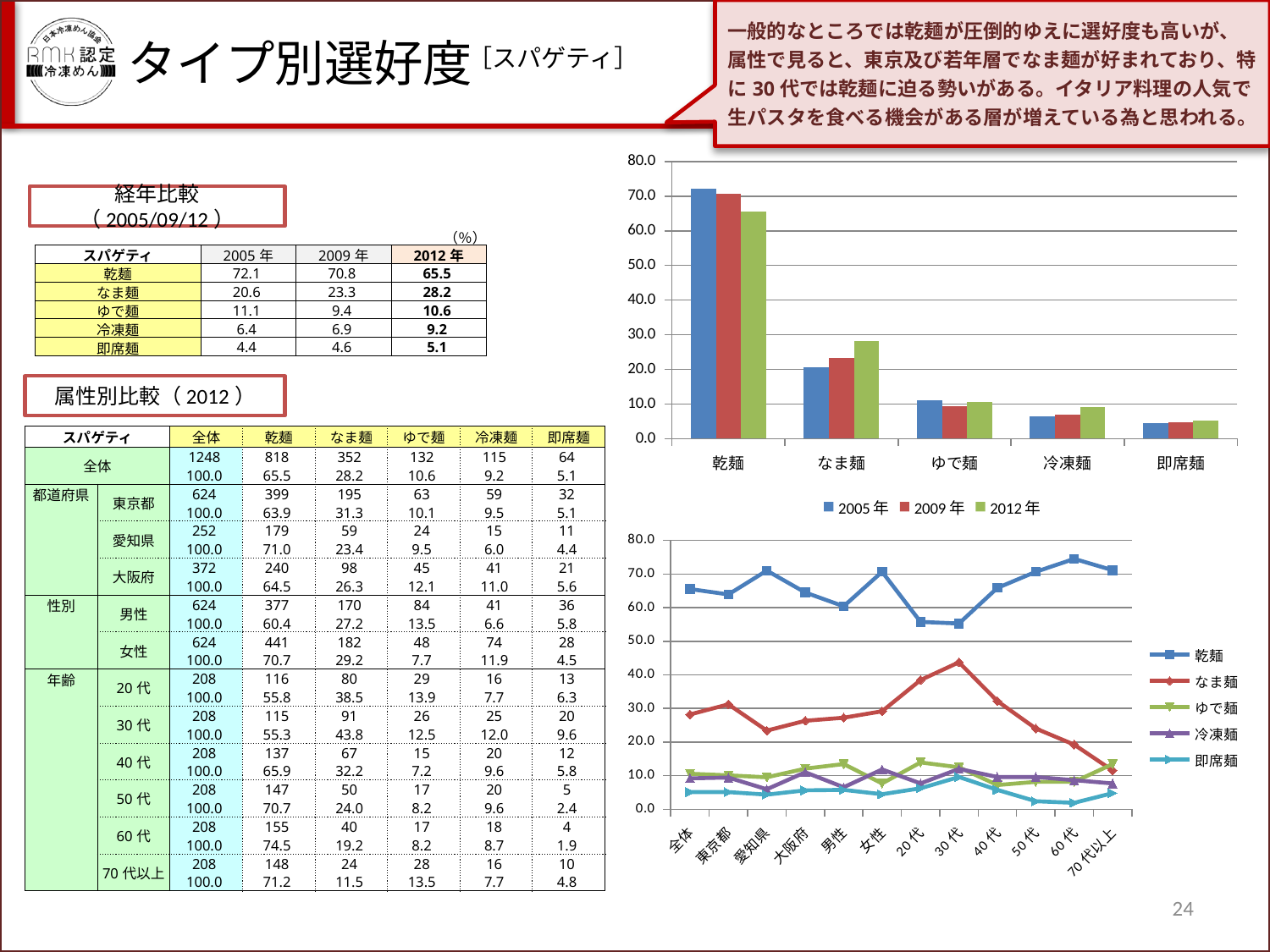
In the bottom line chart, how many series does the legend list? 5 In the top bar chart, do the values for なま麺 rise or fall from 2005年 to 2012年? rise What kind of chart is the top chart on the right of the slide? bar chart In the top bar chart, is the 2005年 value for 乾麺 greater or less than 70.0? greater In the top bar chart, how many categories are shown on the x axis? 5 In the bottom line chart, is the 乾麺 value for 30代 greater or less than 60.0? less What kind of chart is the bottom chart on the right of the slide? line chart In the top bar chart, how many series does the legend list? 3 In the bottom line chart, how many categories are shown on the x axis? 12 In the bottom line chart, which category has the highest value for なま麺? 30代 In the top bar chart, which category has the highest value for 2012年? 乾麺 In the bottom line chart, is the なま麺 value larger for 東京都 or for 愛知県? 東京都